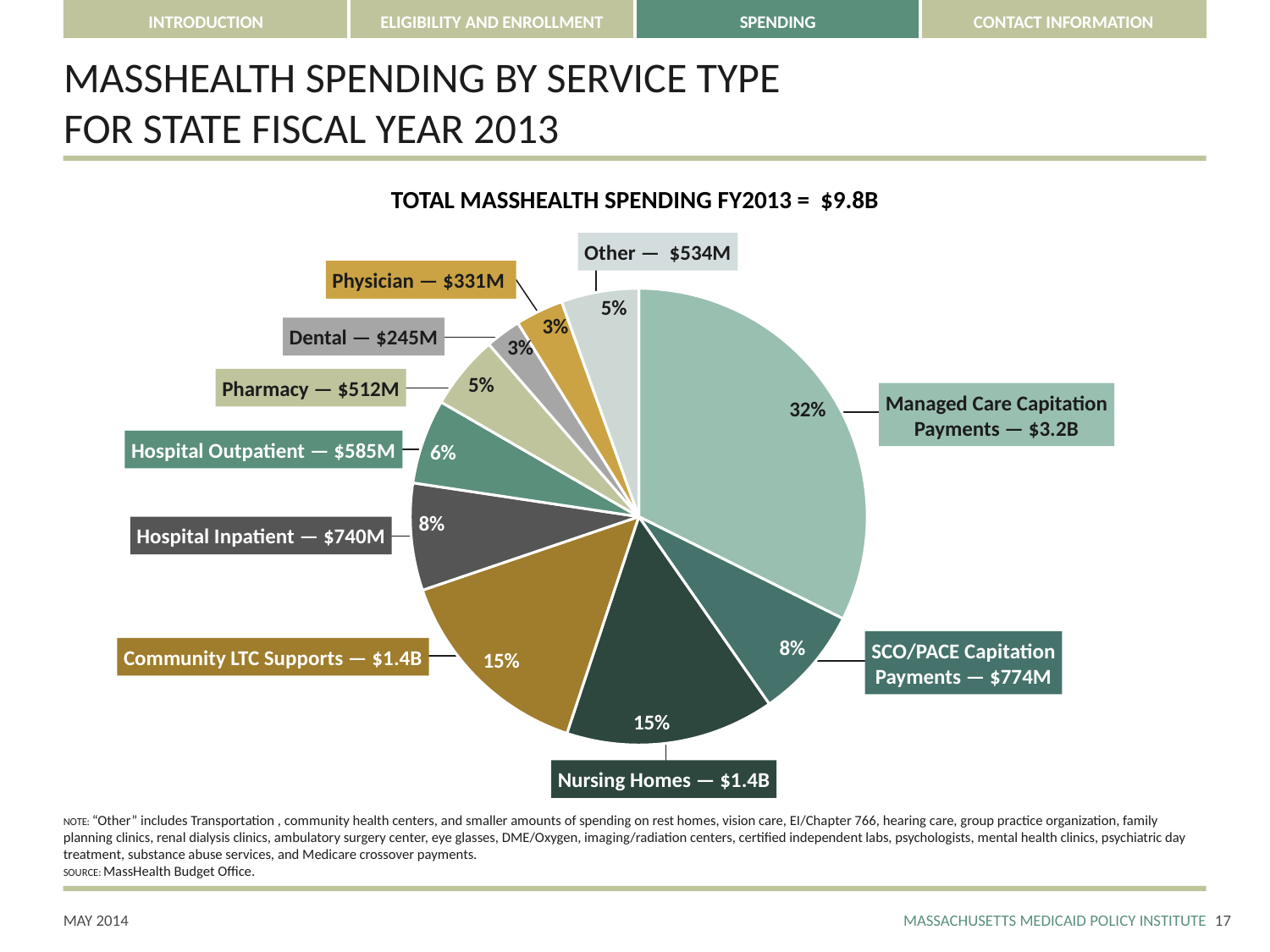
Which has higher spending, Physician or Dental? Physician How many service type categories are shown in the pie chart? 10 What is the total MassHealth spending for FY2013 shown on the slide? $9.8B What is the difference in spending between Hospital Inpatient and Hospital Outpatient? $155M Which service type has the smallest spending amount? Dental What type of chart is shown on the slide? Pie chart What is the spending amount for Hospital Outpatient? $585M What is the spending amount for Managed Care Capitation Payments? $3.2B What share of total spending do Nursing Homes represent? 15% Which service type has the largest share of spending? Managed Care Capitation Payments What is the title of the slide? MassHealth Spending by Service Type for State Fiscal Year 2013 What share of total spending does SCO/PACE Capitation Payments represent? 8%